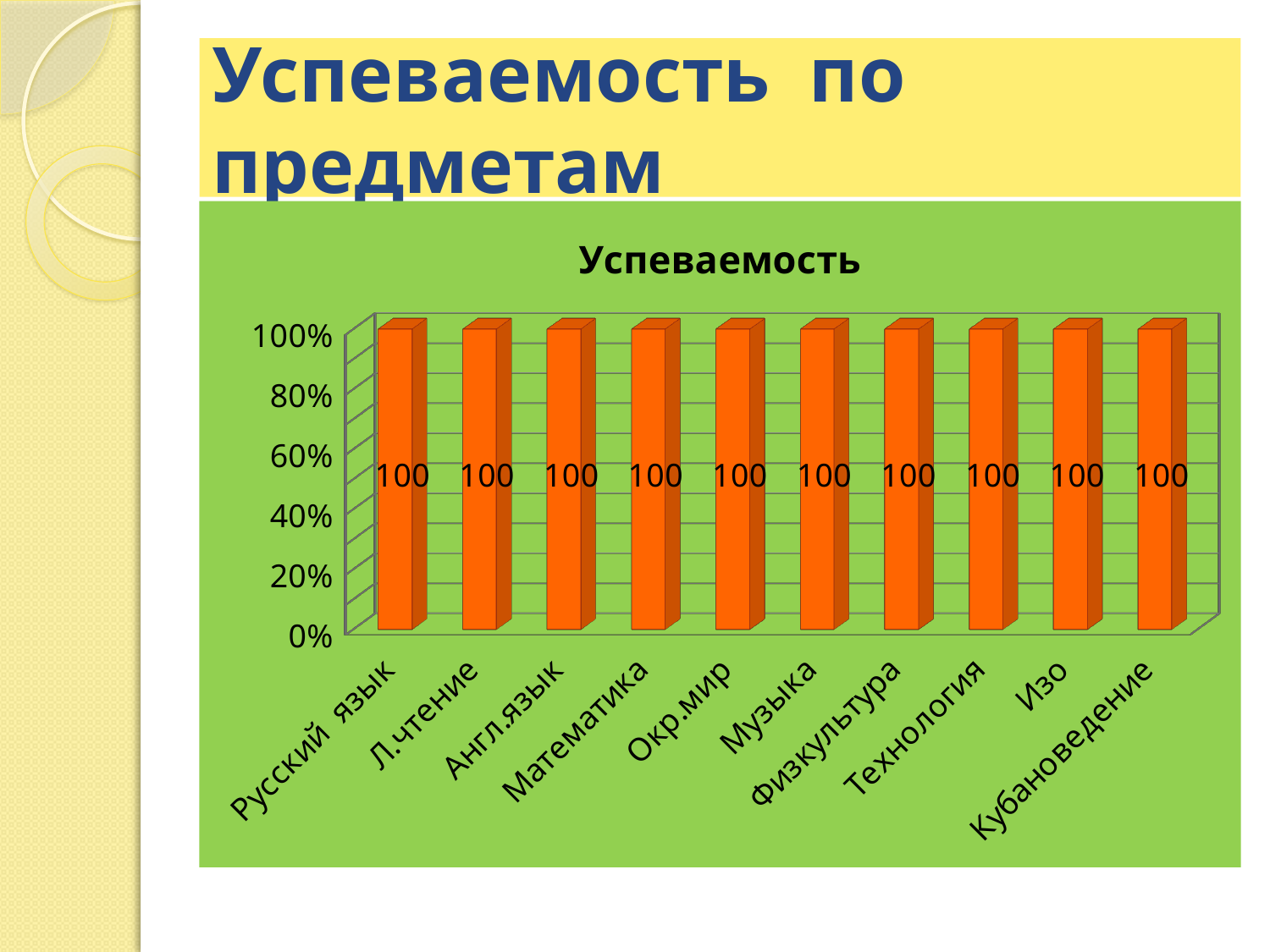
What is the difference between the values for Музыка and Изо? 0 Do the values rise, fall or stay the same across the categories from left to right? stay the same What is the value for Математика? 100 What is the value for Русский язык? 100 Is the value for Технология greater or less than 80%? greater What kind of chart is this? bar chart Is the value for Л.чтение greater or less than 60%? greater What colour are the bars? orange What is the value for Физкультура? 100 What is the value for Кубановедение? 100 What is the title of the chart? Успеваемость How many categories are shown on the x axis? 10